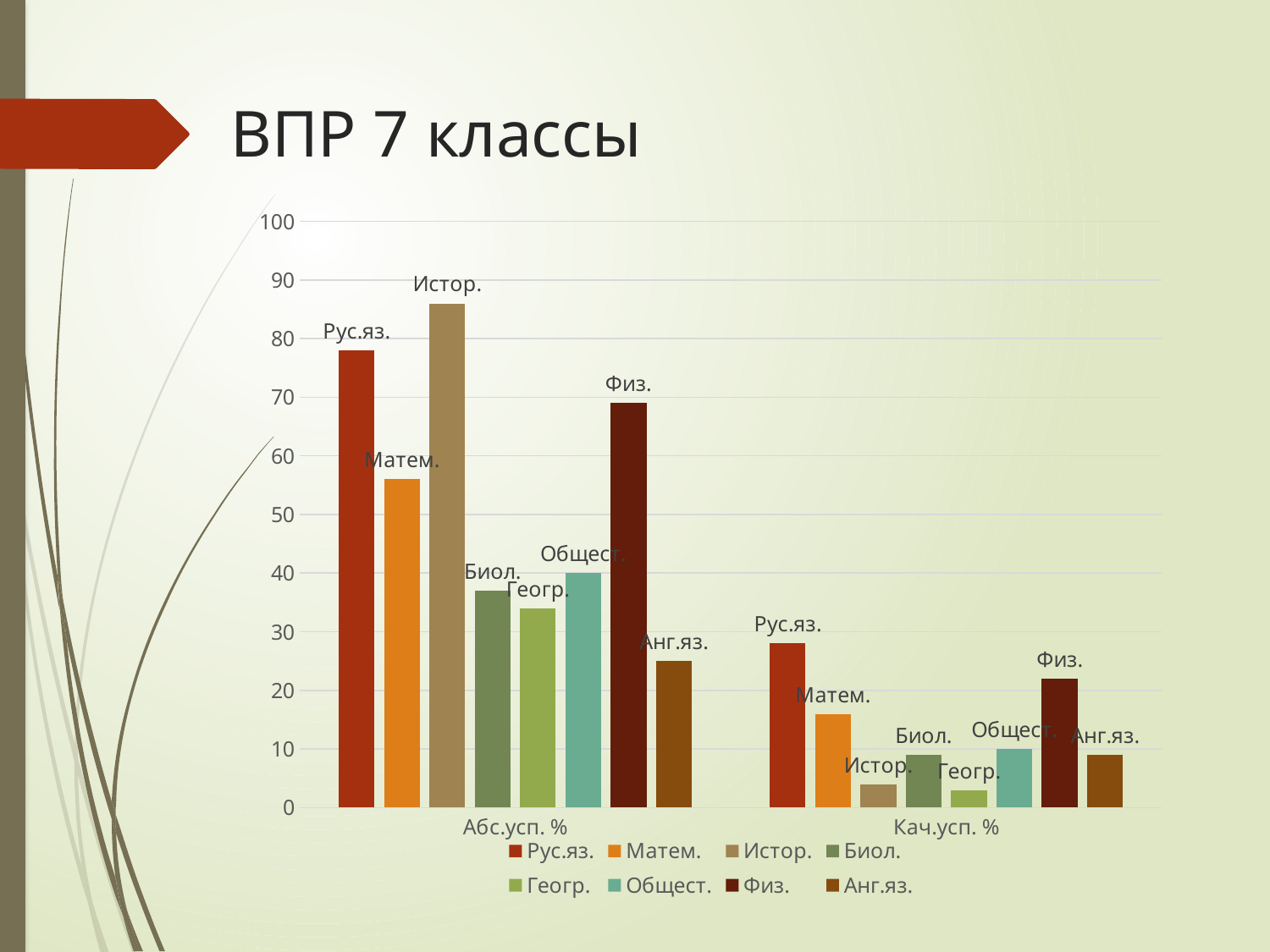
Is the value for Рус.яз. in Абс.усп. % greater or less than 70? greater Which subject has the lowest bar in the Абс.усп. % category? Анг.яз. How many categories are shown on the x axis? 2 Which subject has the highest bar in the Абс.усп. % category? Истор. In the Кач.усп. % category, which is larger: Физ. or Матем.? Физ. Which subject has the highest bar in the Кач.усп. % category? Рус.яз. Is the value for Истор. in Кач.усп. % greater or less than 10? less What is the title of the slide containing the chart? ВПР 7 классы Is the value for Анг.яз. in Абс.усп. % greater or less than 30? less What kind of chart is shown on the slide? bar chart How many series does the legend list? 8